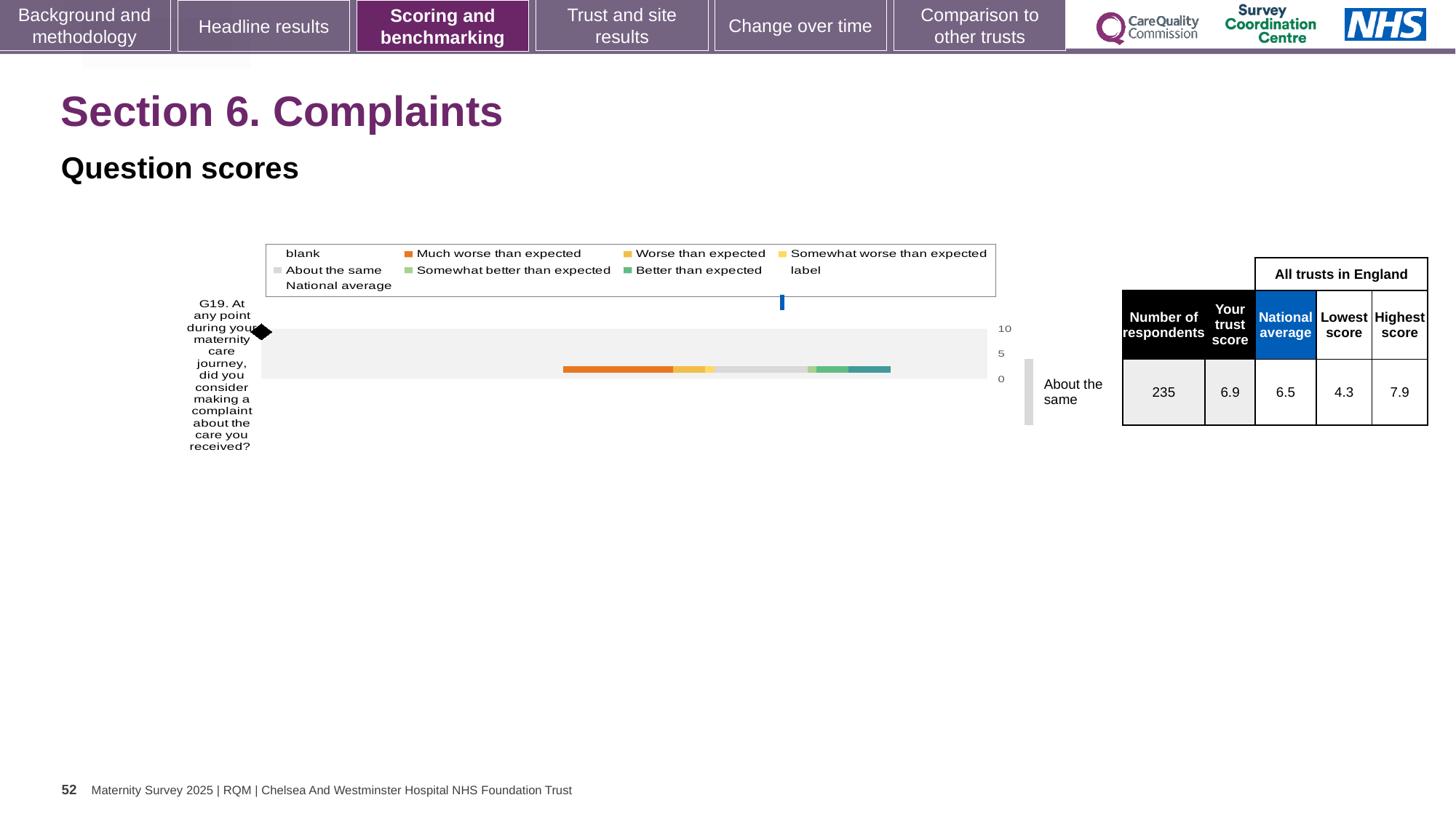
What is the difference between the highest score and the lowest score for question G19? 3.6 What is the highest score among all trusts in England for question G19? 7.9 What kind of chart is shown on the slide? bar chart How many respondents answered question G19? 235 How many questions (categories) are plotted on the chart? 1 What benchmark category is shown for question G19? About the same What is the national average for question G19? 6.5 Which is larger for question G19, the trust score or the national average? trust score What is the question code of the item plotted on the chart? G19 Which legend entry is shown in orange? Much worse than expected What is the trust score for question G19? 6.9 How many entries does the chart legend list? 9